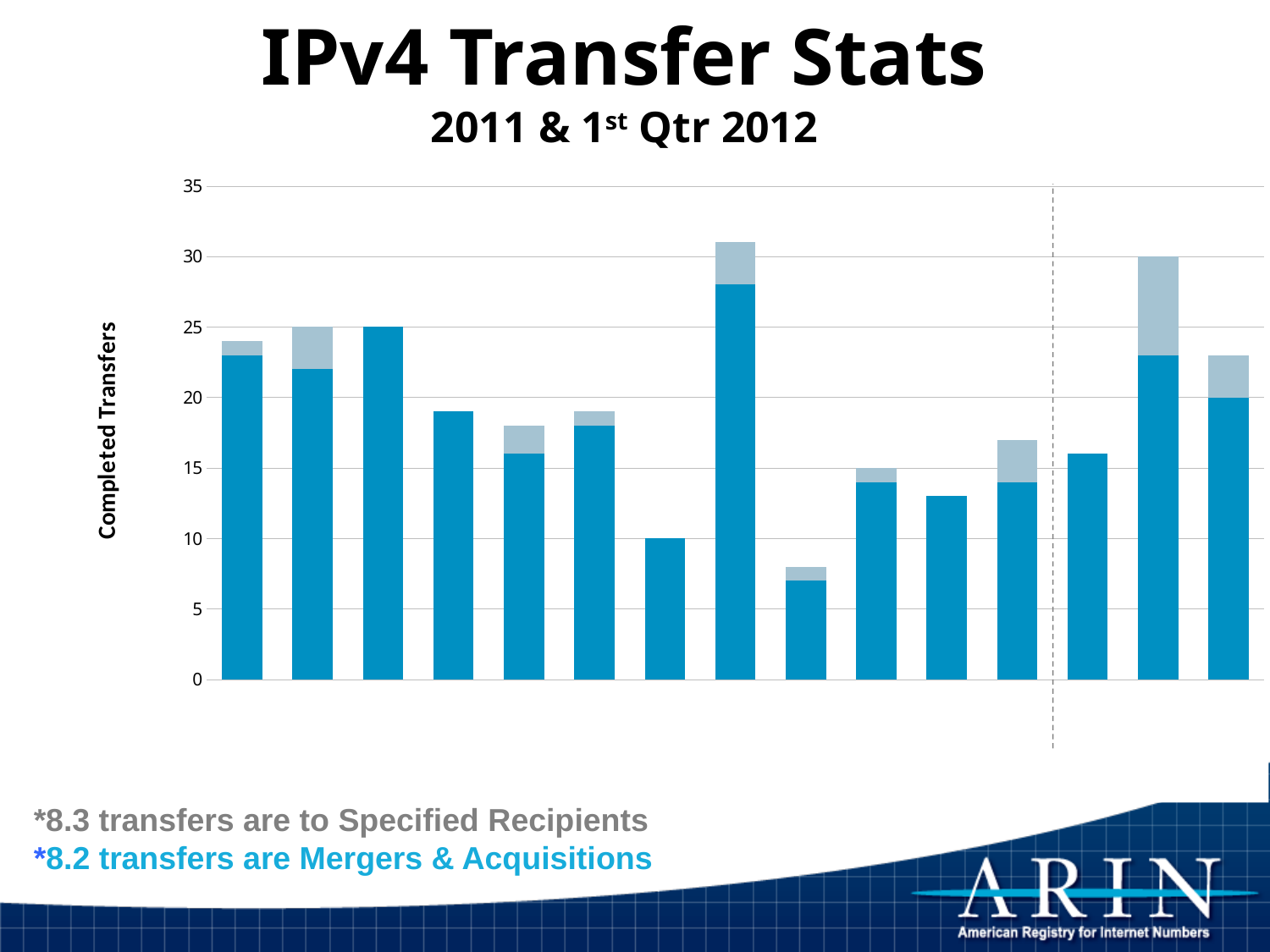
Which bar is the lowest in the chart? The ninth bar from the left Is the total value of the ninth bar from the left greater or less than 10? less Which is taller, the third bar from the left or the fourth bar from the left? The third bar What is the title of the chart on the slide? IPv4 Transfer Stats What is the label on the vertical axis of the chart? Completed Transfers What kind of chart is shown on the slide? Bar chart How many series are stacked in each bar of the chart? 2 Is the total value of the eighth bar from the left greater or less than 30? greater What is the total height of the seventh bar from the left? 10 Is the total value of the first bar from the left greater or less than 20? greater What is the total height of the third bar from the left? 25 How many bars are plotted in the chart? 15